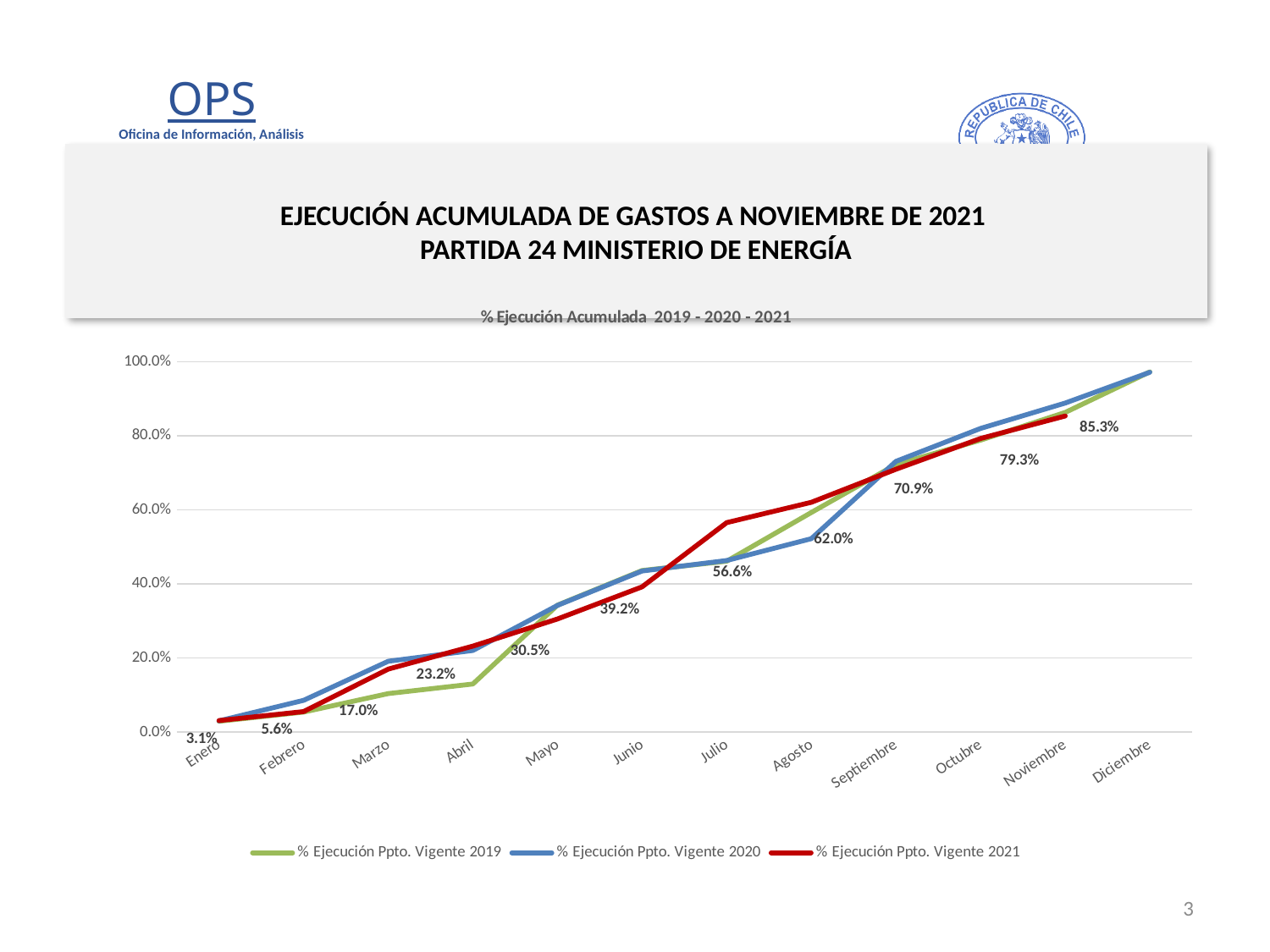
Do the values for % Ejecución Ppto. Vigente 2021 rise or fall from Enero to Noviembre? Rise What is the value of % Ejecución Ppto. Vigente 2021 for Julio? 56.6% What is the title of the chart? % Ejecución Acumulada 2019 - 2020 - 2021 How many months are shown along the x axis? 12 What kind of chart is shown on the slide? Line chart What is the difference between the 2021 values for Julio and Junio? 17.4 percentage points What is the difference between the 2021 values for Noviembre and Octubre? 6.0 percentage points How many series does the legend list? 3 Which month has the highest labelled value for % Ejecución Ppto. Vigente 2021? Noviembre What is the value of % Ejecución Ppto. Vigente 2021 for Enero? 3.1% Is the value for % Ejecución Ppto. Vigente 2020 in Diciembre greater or less than 80.0%? greater What is the value of % Ejecución Ppto. Vigente 2021 for Noviembre? 85.3%